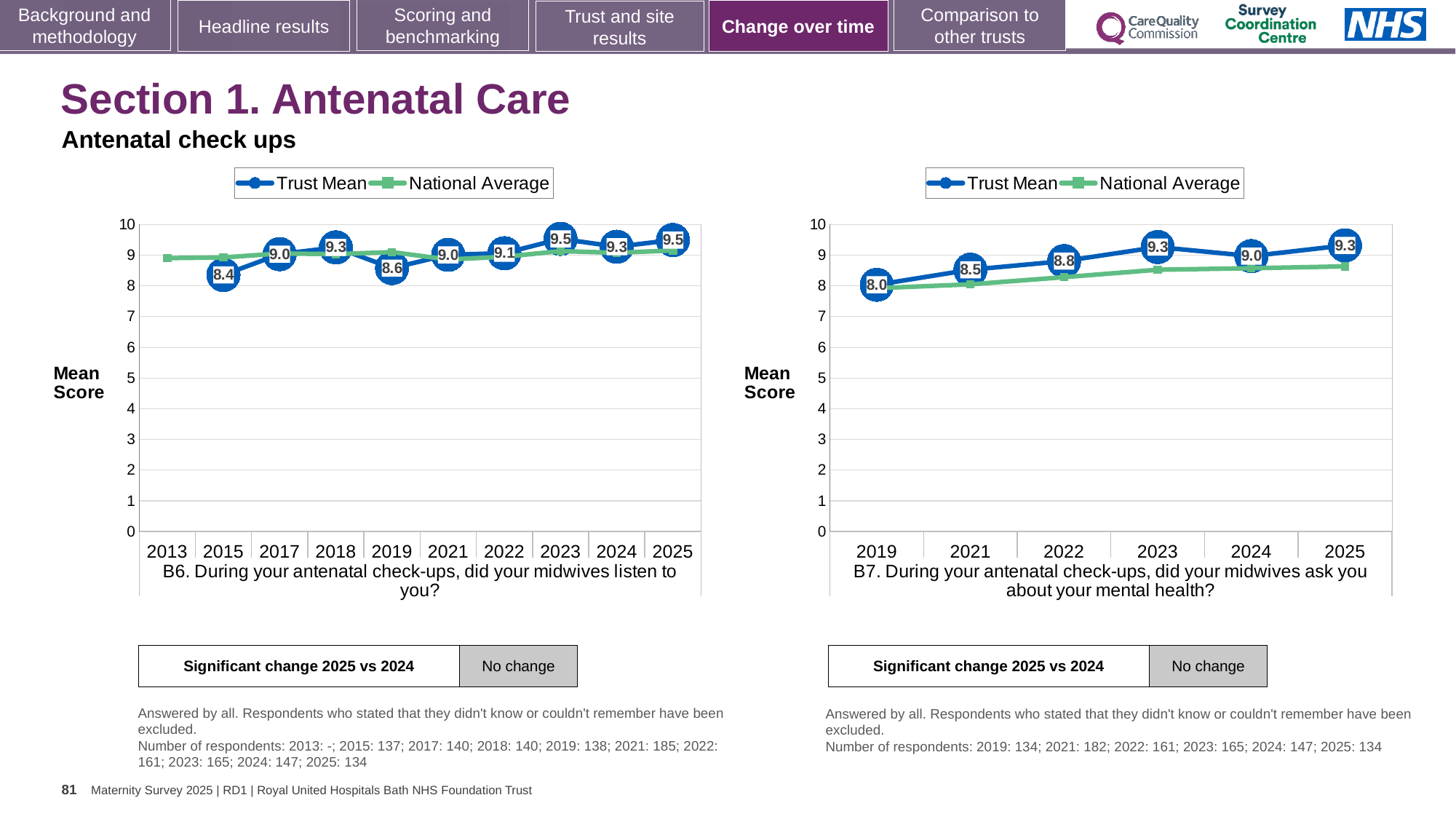
In the right chart (B7), is the National Average value for 2019 greater or less than 9? less How many years are shown on the x axis of the right chart (B7)? 6 How many series does the legend of the left chart (B6) list? 2 In the left chart (B6), what is the difference between the Trust Mean score in 2025 and in 2015? 1.1 In the left chart (B6), which year has the lowest Trust Mean score? 2015 In the left chart (B6), what is the Trust Mean score for 2019? 8.6 In the right chart (B7), which year has the lowest Trust Mean score? 2019 In the right chart (B7), what is the Trust Mean score for 2022? 8.8 In the left chart (B6), which year has the higher Trust Mean score, 2018 or 2019? 2018 In the left chart (B6), what is the Trust Mean score for 2015? 8.4 In the right chart (B7), what is the difference between the Trust Mean score in 2025 and in 2019? 1.3 What kind of chart is the right chart (B7)? Line chart